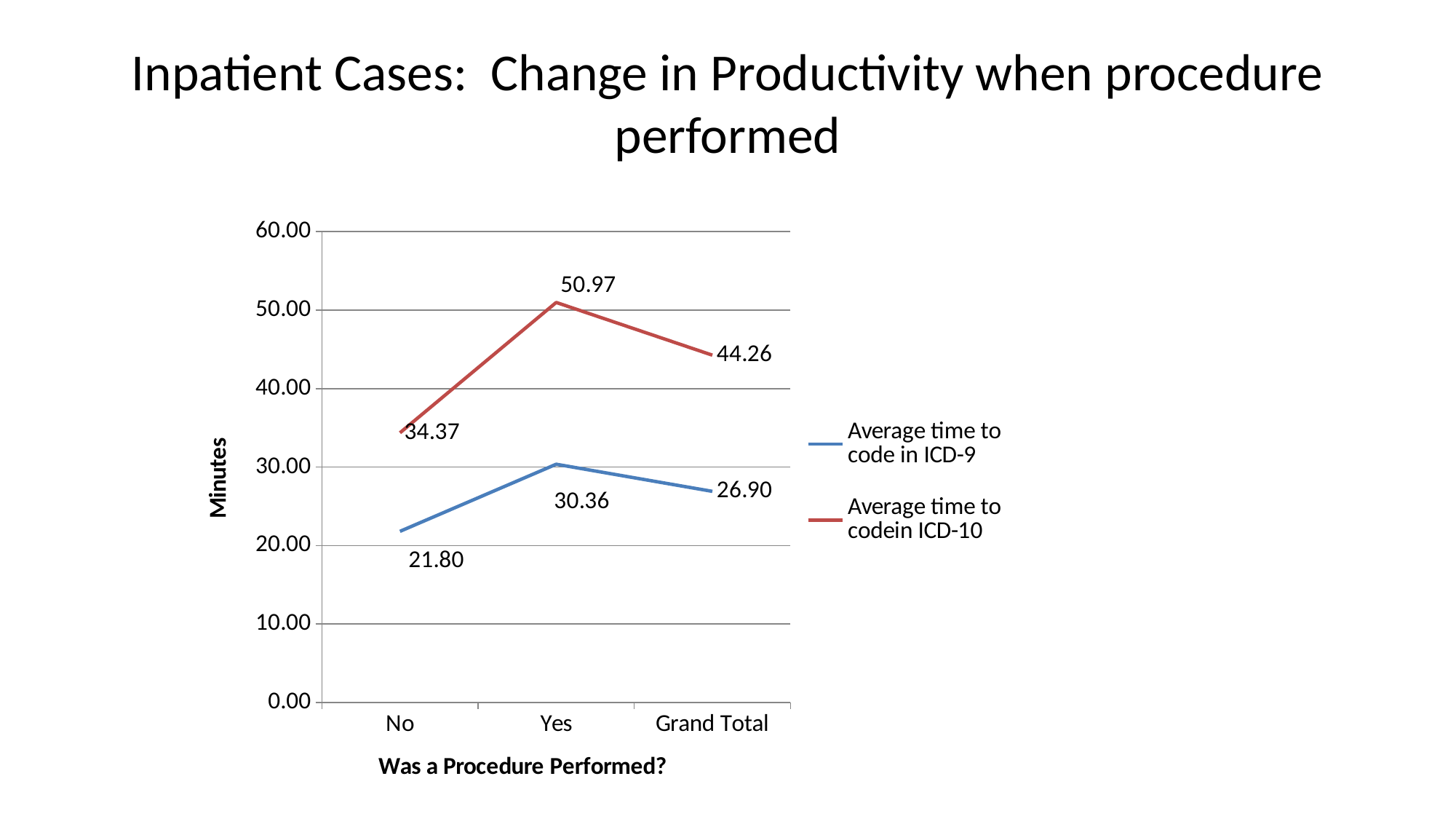
Which category has the lowest average time to code in ICD-9? No How many categories are shown on the x axis? 3 Which category has the highest average time to code in ICD-10? Yes What kind of chart is shown on the slide? Line chart What is the difference between the ICD-10 and ICD-9 average coding times for the Yes category? 20.61 What is the average time to code in ICD-9 for the Yes category? 30.36 What is the difference between the ICD-10 average coding time for Yes and for No? 16.60 Which is larger for the Grand Total: the average time to code in ICD-9 or in ICD-10? Average time to code in ICD-10 What is the average time to code in ICD-10 when a procedure was performed (Yes)? 50.97 What is the average time to code in ICD-9 when no procedure was performed (No)? 21.80 What is the Grand Total average time to code in ICD-10? 44.26 How many series does the legend list? 2